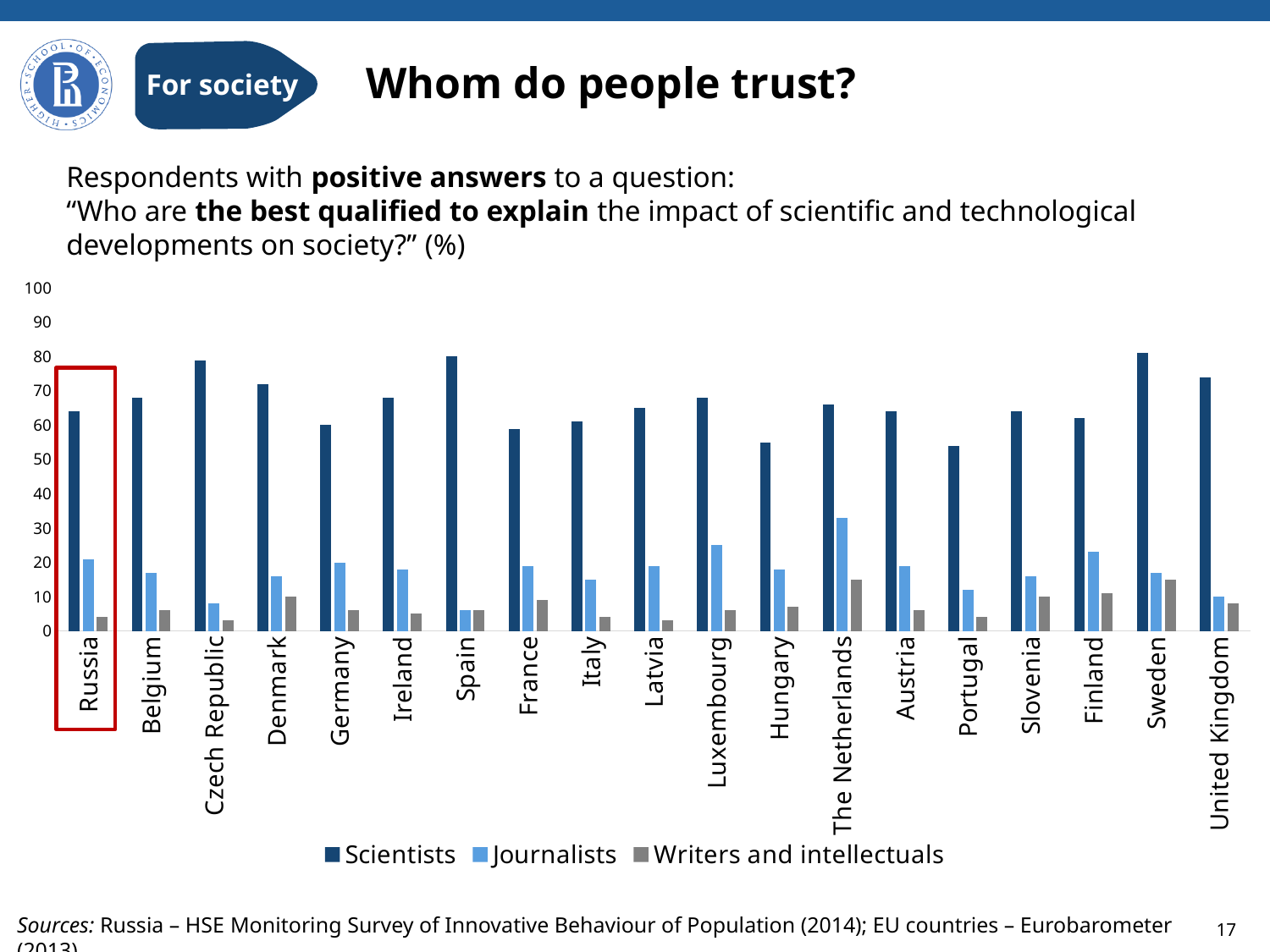
Is the value for Scientists in Portugal greater or less than 60? less How many series does the legend list? 3 Is the value for Journalists in The Netherlands greater or less than 30? greater Which country is highlighted with a red box on the chart? Russia Is the value for Scientists in Hungary greater or less than 60? less Which country has the highest value for Journalists? The Netherlands What kind of chart is shown on the slide? bar chart Which is larger, the Scientists value for the Czech Republic or for Germany? Czech Republic Which is larger, the Journalists value for The Netherlands or for Russia? The Netherlands How many countries are shown on the x axis? 19